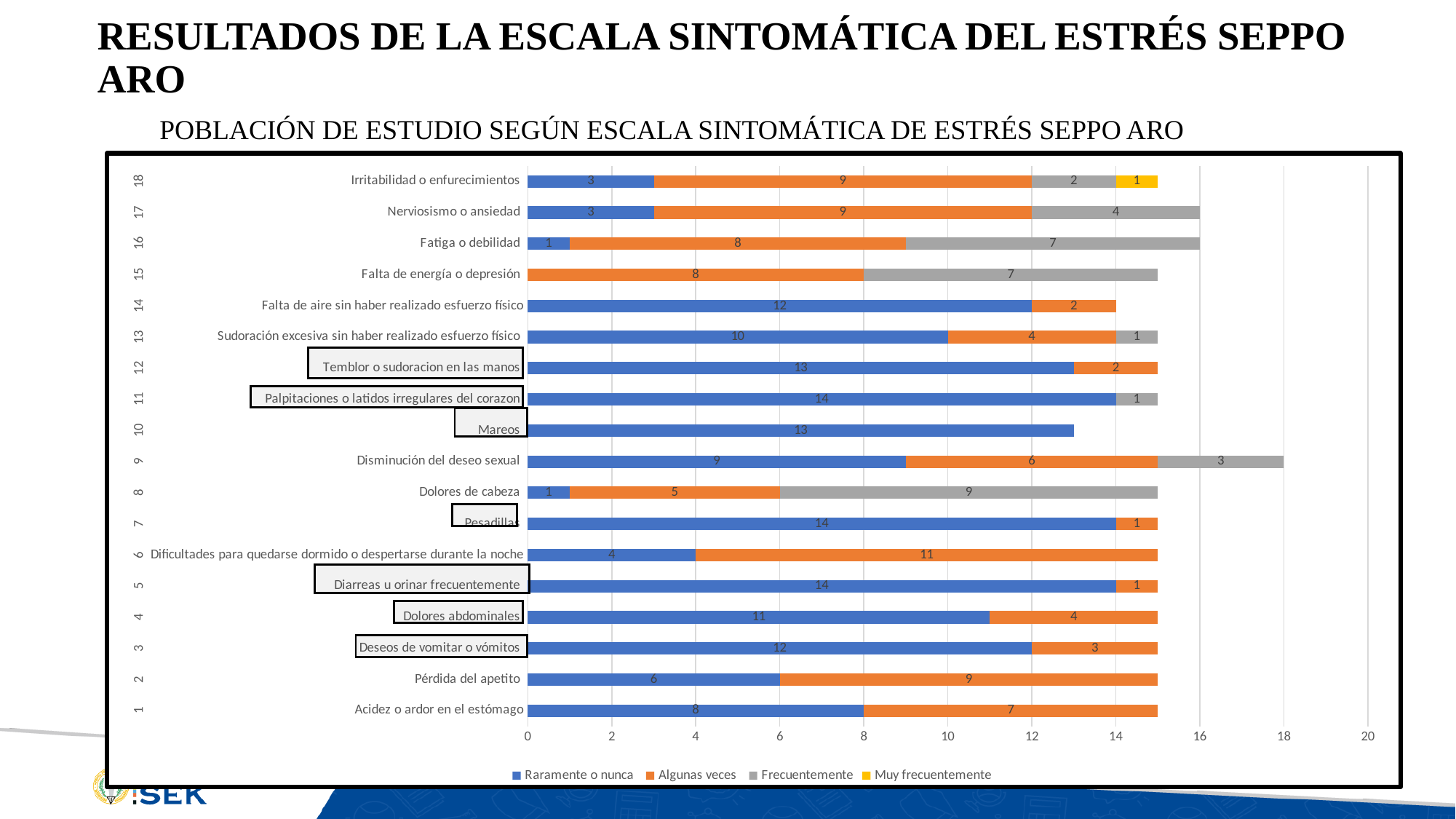
Which category is the only one with a 'Muy frecuentemente' value? Irritabilidad o enfurecimientos What is the value of 'Frecuentemente' for 'Dolores de cabeza'? 9 Which is larger: the 'Algunas veces' value for 'Fatiga o debilidad' or for 'Dolores abdominales'? Fatiga o debilidad What is the difference between the 'Raramente o nunca' values for 'Falta de aire sin haber realizado esfuerzo físico' and 'Pérdida del apetito'? 6 How many symptom categories are plotted on the chart? 18 What kind of chart is shown on the slide? Stacked bar chart How many series does the legend list? 4 What is the value of 'Algunas veces' for 'Dificultades para quedarse dormido o despertarse durante la noche'? 11 What is the total of the stacked bar for 'Disminución del deseo sexual'? 18 What is the total of the stacked bar for 'Nerviosismo o ansiedad'? 16 Which category has the longest stacked bar overall? Disminución del deseo sexual What is the value of 'Raramente o nunca' for 'Mareos'? 13